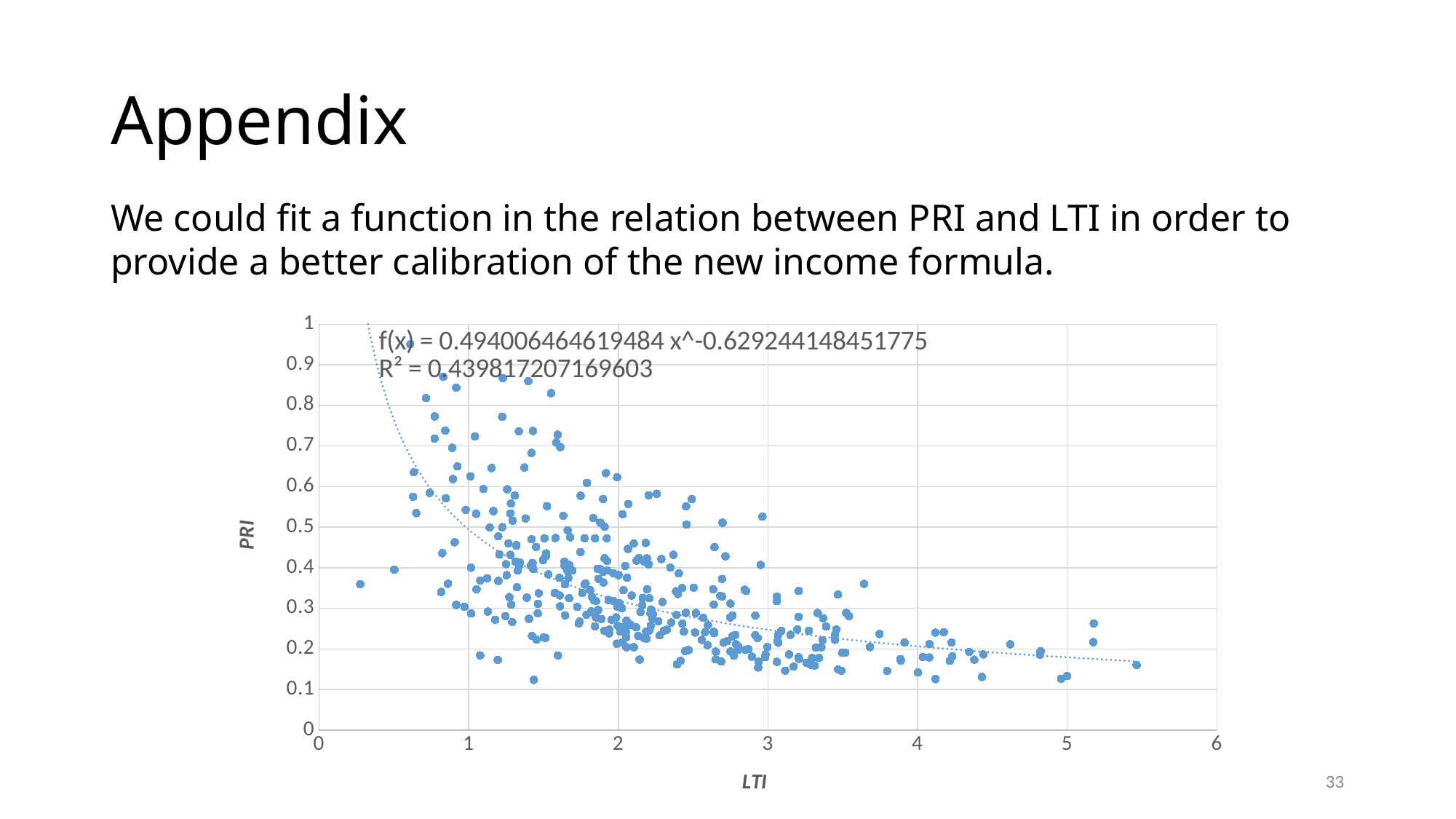
What R² value is printed on the chart for the fitted function? 0.439817207169603 Is the largest LTI value plotted on the chart greater or less than 5? greater What variable is plotted on the y axis of the chart? PRI Is the highest PRI value plotted on the chart greater or less than 0.8? greater Is the R² value printed on the chart greater or less than 0.5? less What kind of chart is shown on the slide? Scatter chart What fitted function f(x) is printed on the chart? f(x) = 0.494006464619484 x^-0.629244148451775 What is the coefficient in the fitted function printed on the chart? 0.494006464619484 What variable is plotted on the x axis of the chart? LTI As LTI increases along the x axis, do the PRI values generally rise or fall? Fall What is the exponent of x in the fitted function printed on the chart? -0.629244148451775